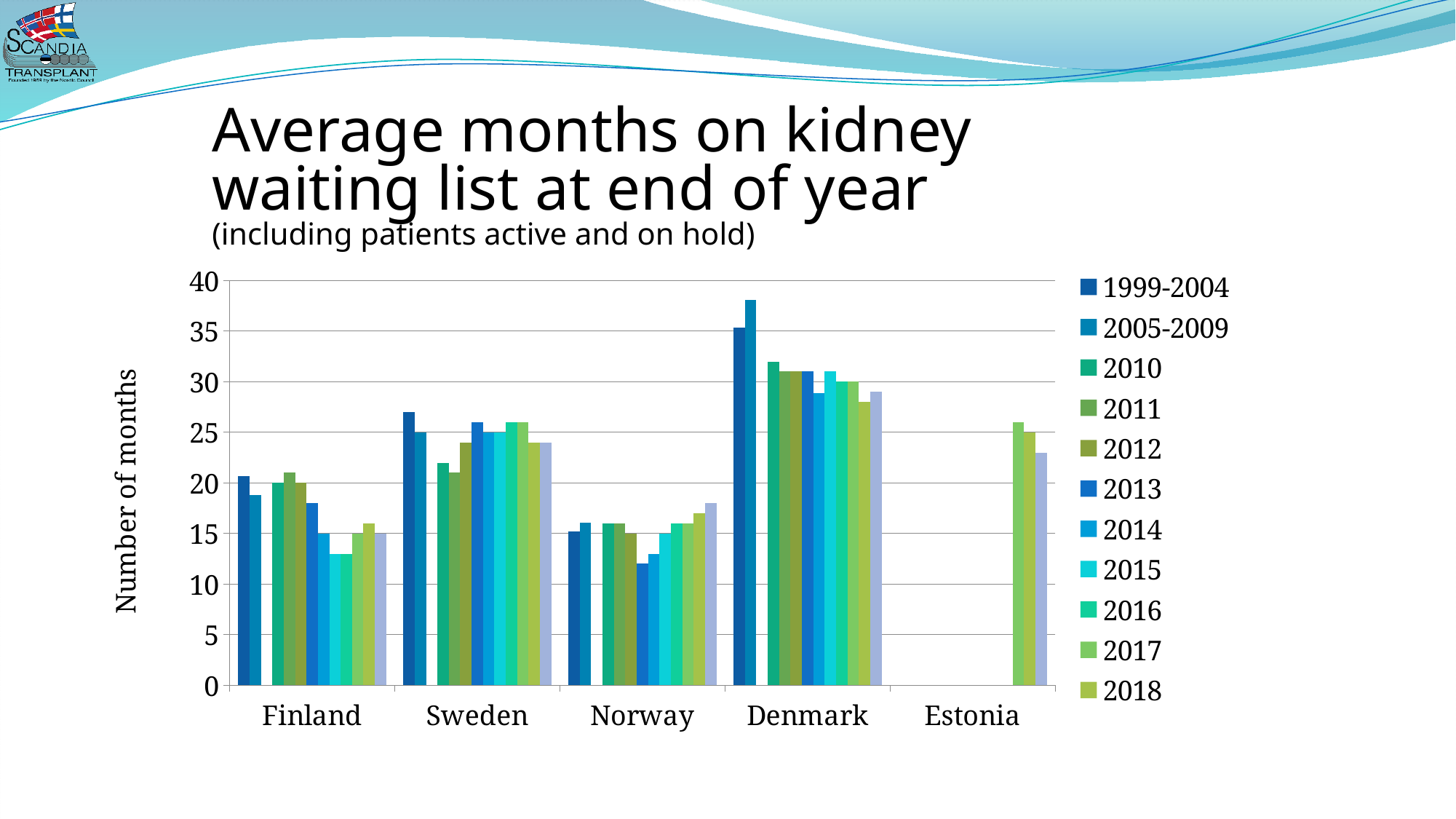
Is the value for Norway in 2013 greater or less than 15? less How many countries are shown on the x axis of the chart? 5 Is the value for Denmark in 2005-2009 greater or less than 35? greater What is the label on the vertical axis of the chart? Number of months How many series does the chart's legend list? 11 What kind of chart is shown on the slide? bar chart Among Finland, Sweden, Norway and Denmark, which country has the lowest value for 2005-2009? Norway Is the value for Sweden in 1999-2004 greater or less than 25? greater Which country has the highest average months on the kidney waiting list in the chart? Denmark Which is larger, the 1999-2004 value for Sweden or the 1999-2004 value for Finland? Sweden